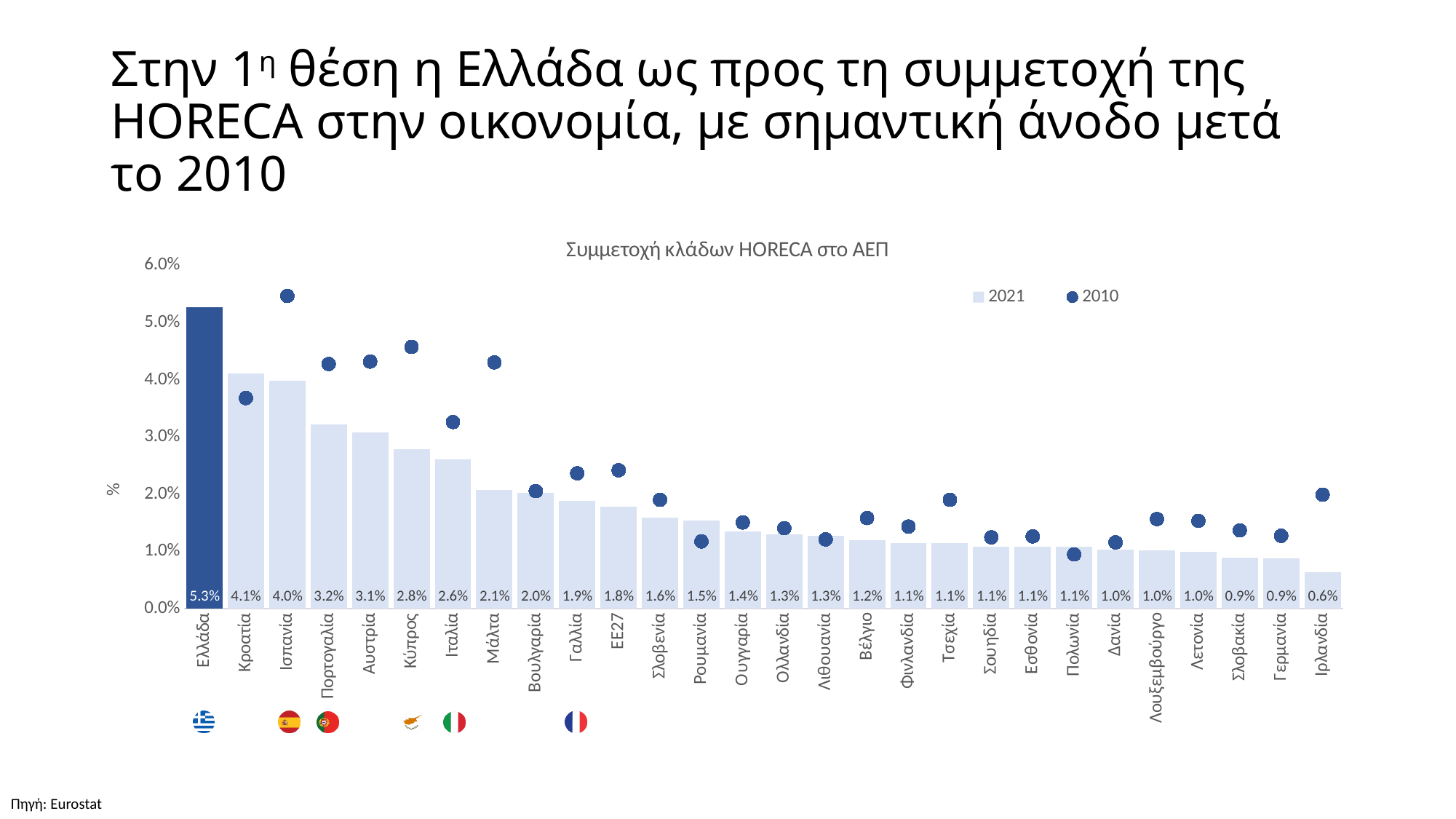
Which has the larger 2021 value, Πορτογαλία or Ιταλία? Πορτογαλία What is the 2021 value for Κύπρος? 2.8% Is the 2010 value for Κροατία greater or less than 4.0%? less What is the title of the chart? Συμμετοχή κλάδων HORECA στο ΑΕΠ Which category has the lowest 2021 value? Ιρλανδία What is the 2021 value for Ελλάδα? 5.3% What is the difference between the 2021 values for Ελλάδα and Κροατία? 1.2% How many categories are shown on the x axis? 28 Is the 2010 value for Ισπανία greater or less than 5.0%? greater Which category has the highest 2021 value? Ελλάδα What is the 2021 value for ΕΕ27? 1.8% How many series does the legend list? 2